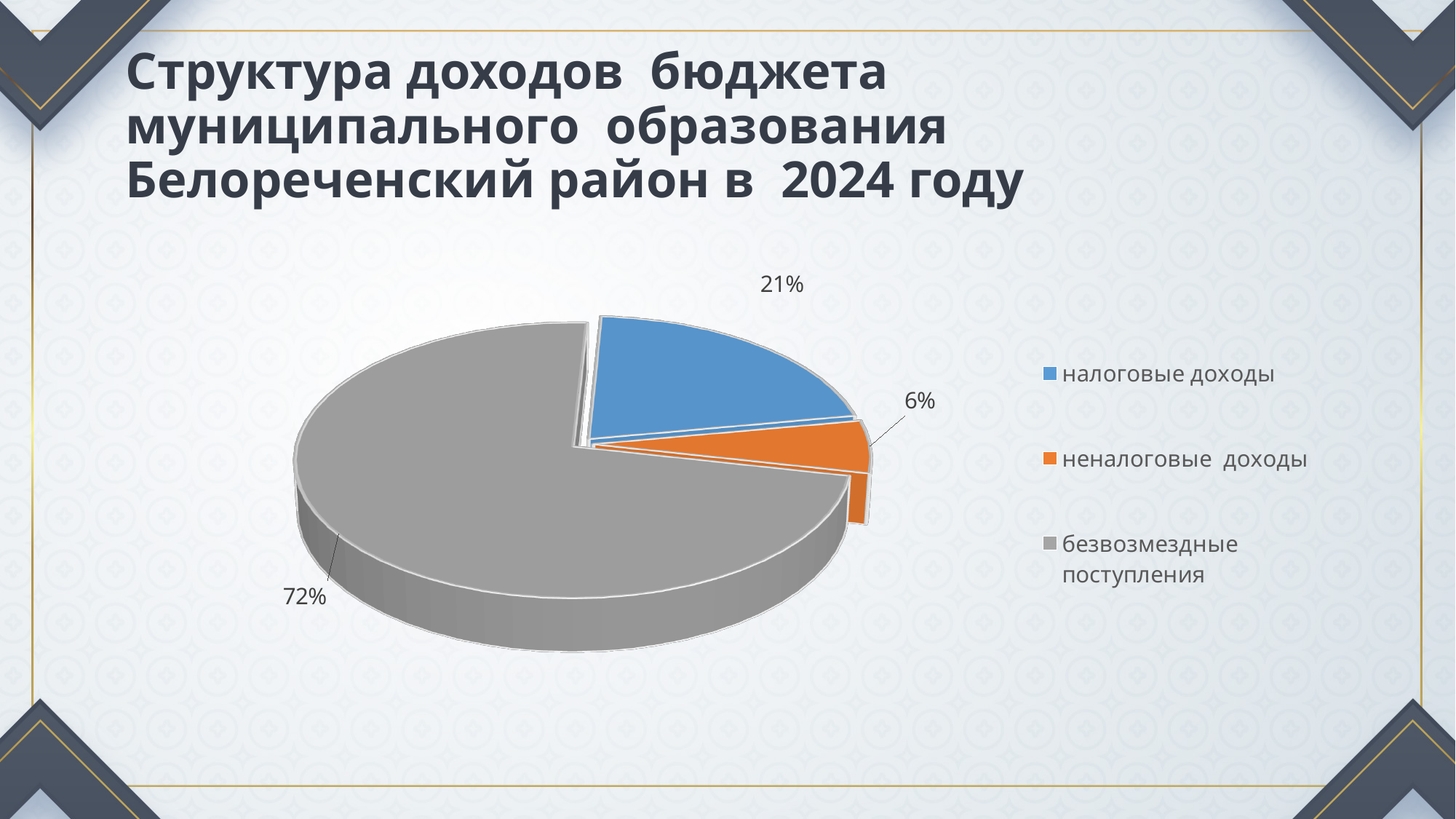
What kind of chart is shown on the slide? pie chart What is the difference in percentage points between безвозмездные поступления and налоговые доходы? 51 How many categories are shown in the pie chart? 3 What colour is the slice for неналоговые доходы? orange Which category has the smallest slice of the pie? неналоговые доходы Which category is shown in grey in the legend? безвозмездные поступления What is the difference in percentage points between налоговые доходы and неналоговые доходы? 15 Which is larger, налоговые доходы or неналоговые доходы? налоговые доходы Which category has the largest slice of the pie? безвозмездные поступления What share of the pie does налоговые доходы represent? 21% What share of the pie does неналоговые доходы represent? 6% What share of the pie does безвозмездные поступления represent? 72%